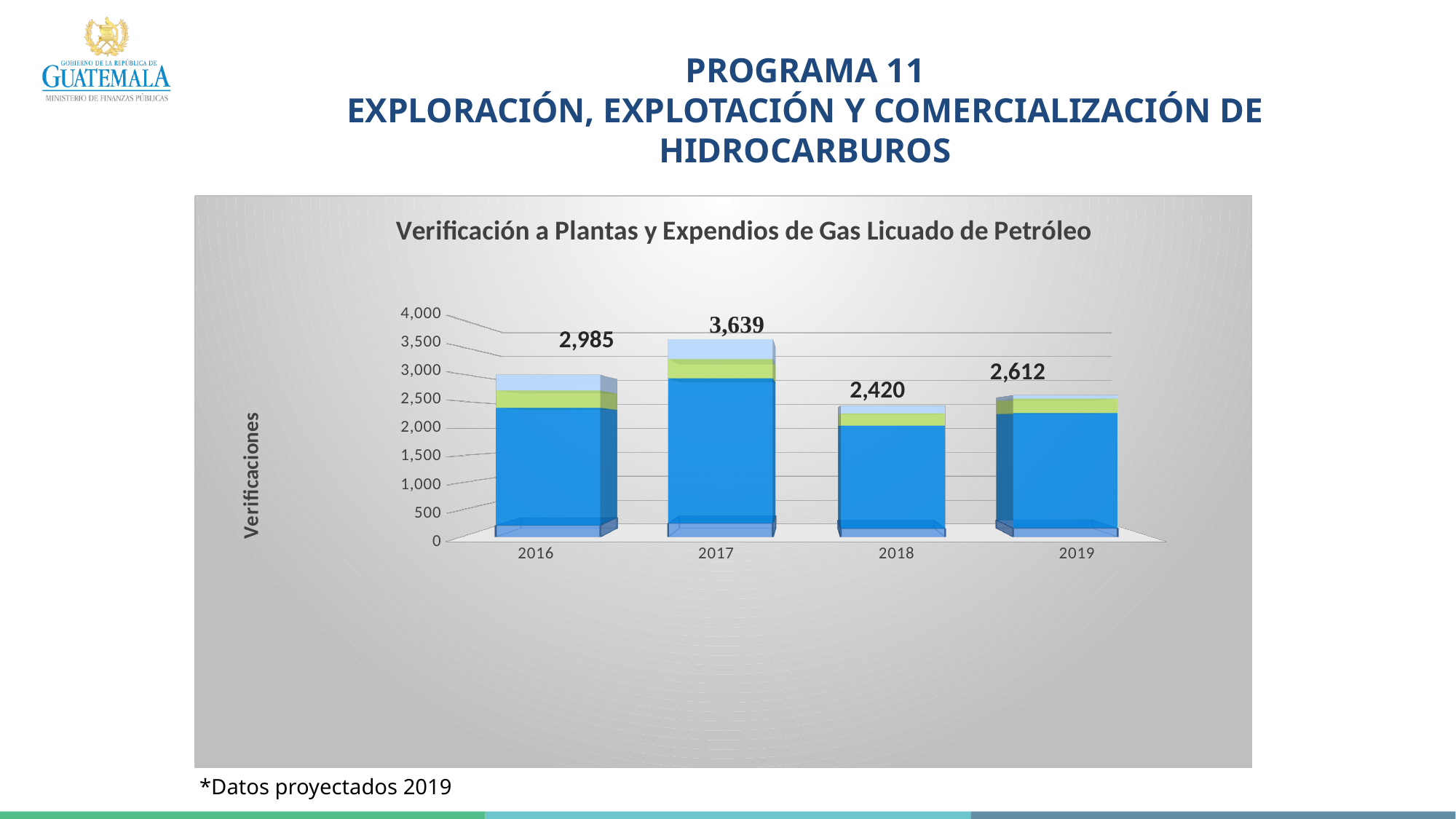
What is the title of the chart? Verificación a Plantas y Expendios de Gas Licuado de Petróleo What is the difference between the totals for 2017 and 2018? 1,219 What is the total value shown for 2017? 3,639 How many years are shown on the x axis? 4 Which year has the lowest total of verifications? 2018 What is the total value shown for 2019? 2,612 What is the total value shown for 2018? 2,420 Which year has the highest total of verifications? 2017 Which year has a larger total, 2016 or 2019? 2016 What is the total value shown for 2016? 2,985 What kind of chart is shown on the slide? Stacked bar chart Is the total for 2018 greater or less than 2,500? less